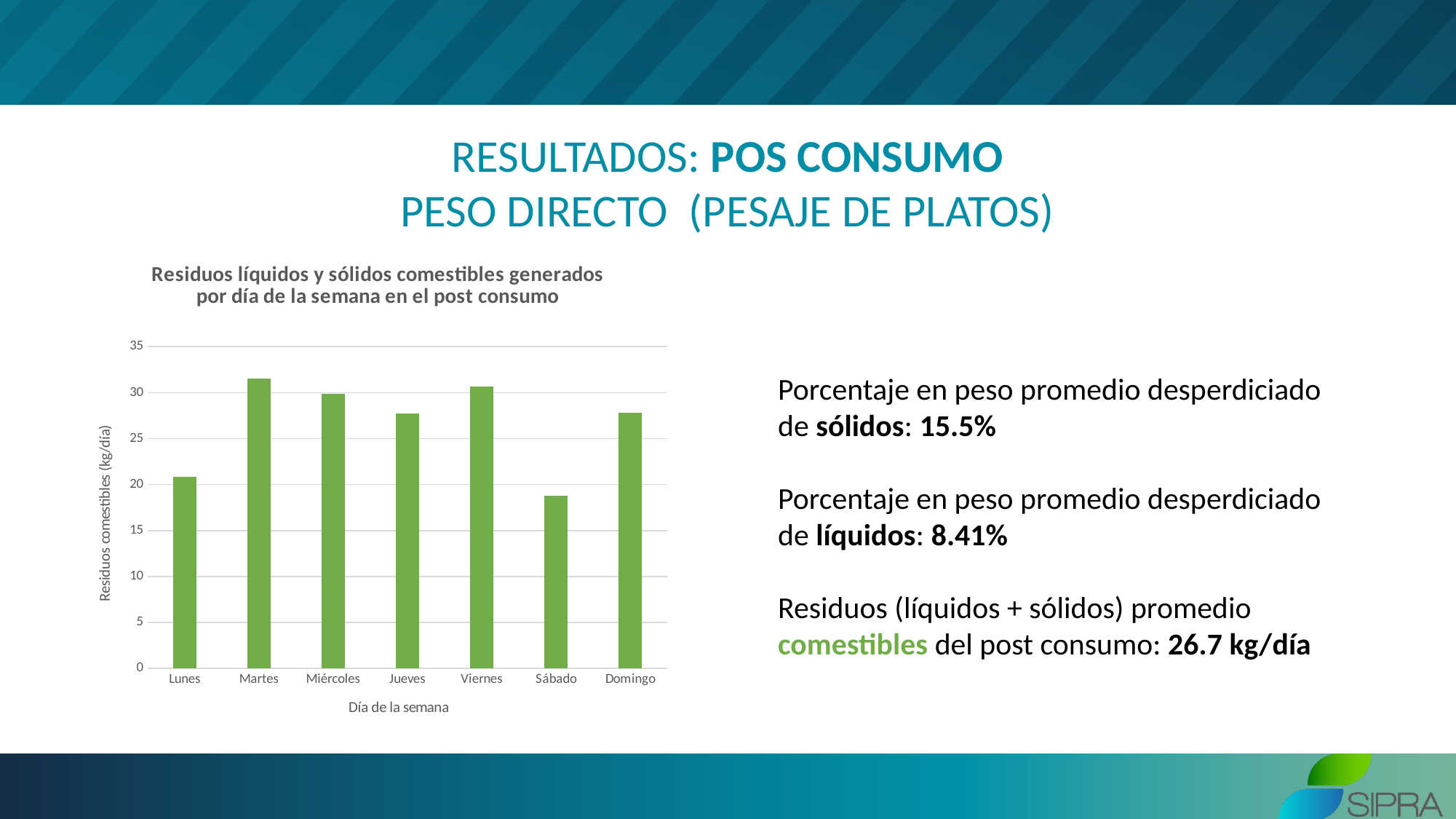
What is the label of the vertical axis of the chart? Residuos comestibles (kg/día) Is the value for Lunes greater or less than 25? less What kind of chart is shown on the slide? bar chart Is the value for Martes greater or less than 30? greater Which has a larger value, Lunes or Sábado? Lunes Is the value for Domingo greater or less than 30? less Which day of the week has the lowest value of residuos comestibles? Sábado How many days of the week are plotted on the chart? 7 Which has a larger value, Miércoles or Jueves? Miércoles Which day of the week has the highest value of residuos comestibles? Martes